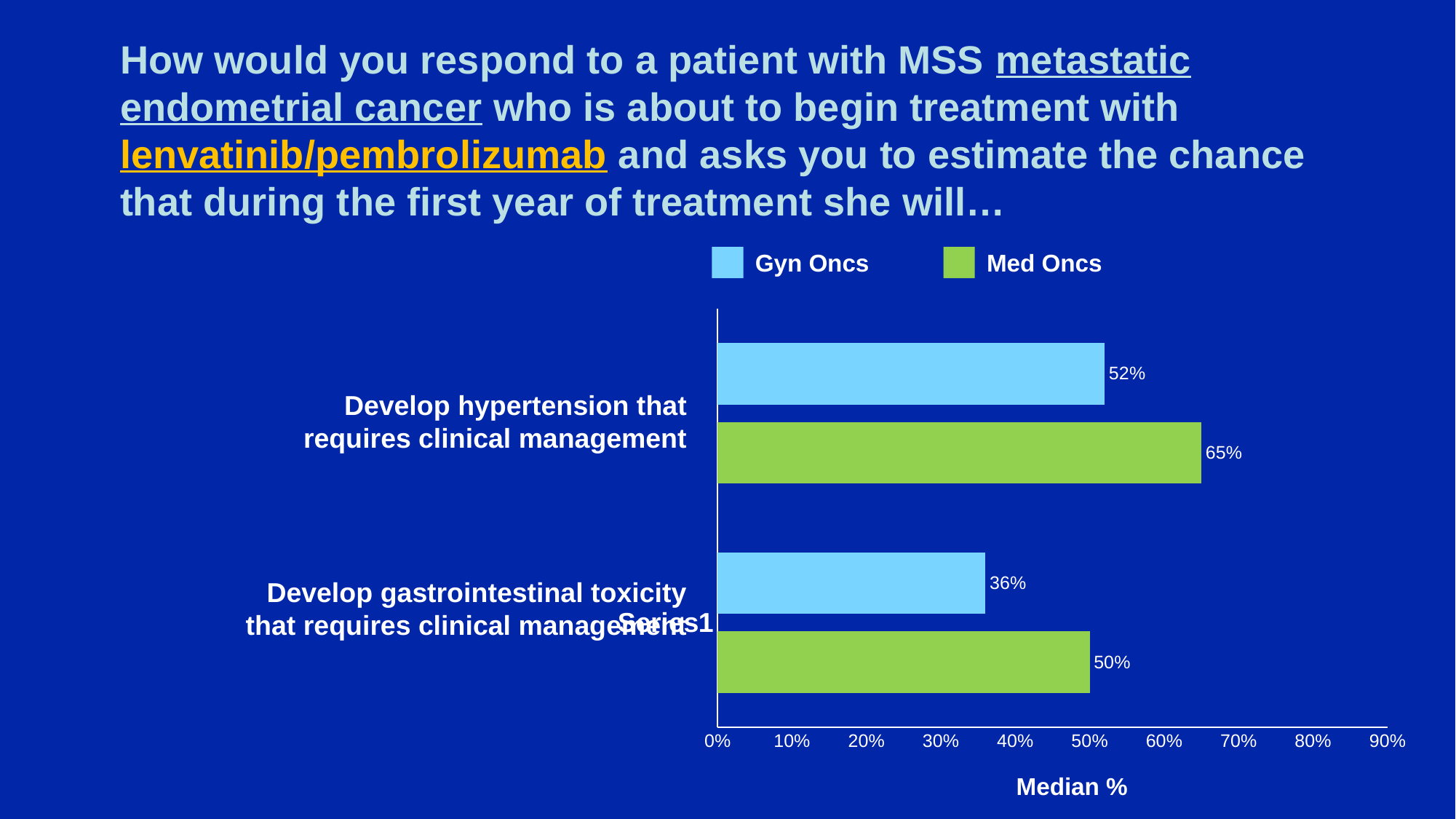
What is the Gyn Oncs value for 'Develop gastrointestinal toxicity that requires clinical management'? 36% What is the difference between the Med Oncs and Gyn Oncs values for 'Develop hypertension that requires clinical management'? 13% For 'Develop gastrointestinal toxicity that requires clinical management', which group has the larger value, Gyn Oncs or Med Oncs? Med Oncs What is the Gyn Oncs value for 'Develop hypertension that requires clinical management'? 52% Which bar has the highest value on the chart? Med Oncs, Develop hypertension that requires clinical management (65%) What is the label of the horizontal axis? Median % What kind of chart is shown on the slide? Bar chart How many series does the legend list? 2 What is the Med Oncs value for 'Develop hypertension that requires clinical management'? 65% Which bar has the lowest value on the chart? Gyn Oncs, Develop gastrointestinal toxicity that requires clinical management (36%) What is the difference between the Med Oncs and Gyn Oncs values for 'Develop gastrointestinal toxicity that requires clinical management'? 14% What is the Med Oncs value for 'Develop gastrointestinal toxicity that requires clinical management'? 50%